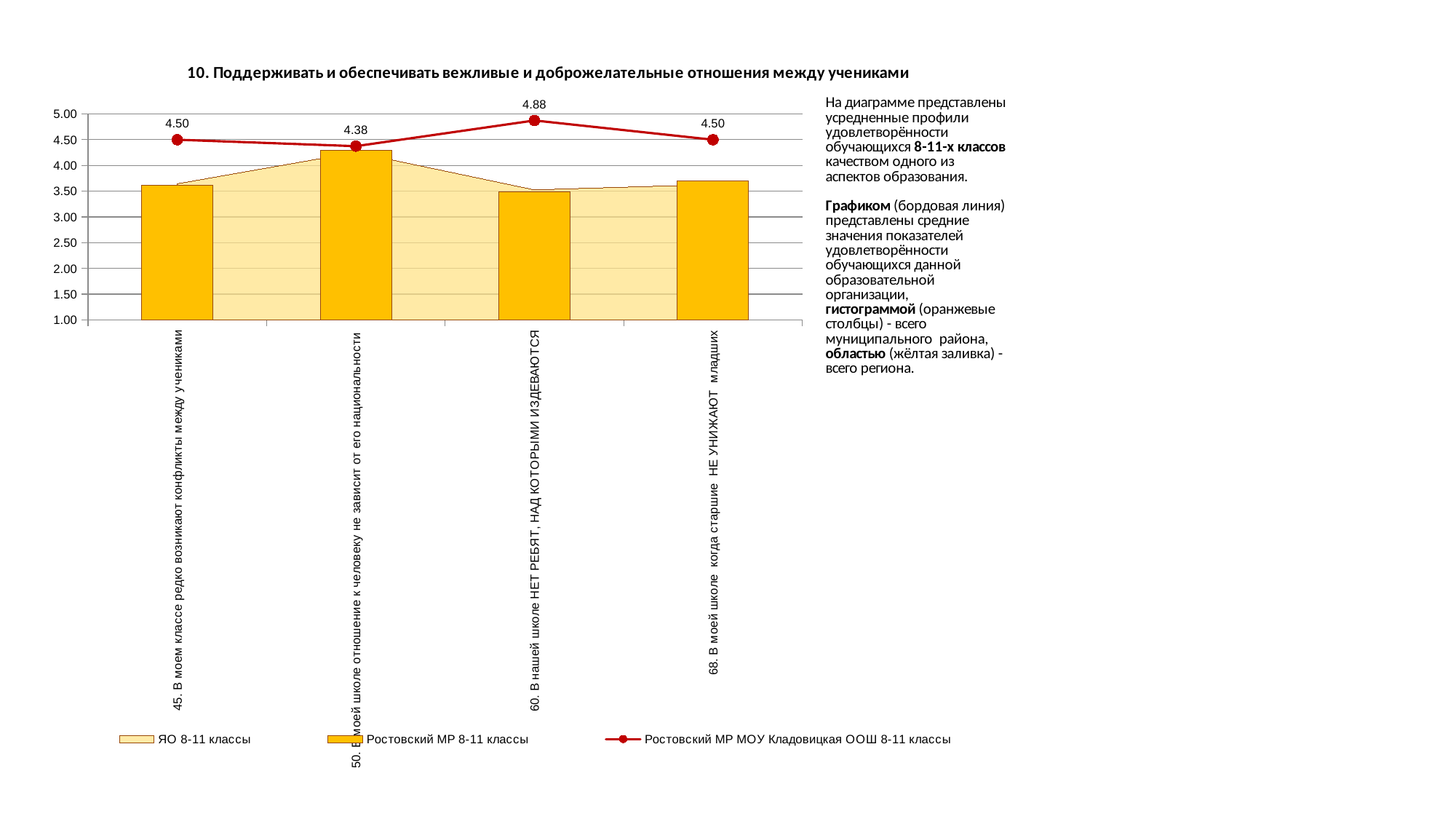
Is the orange bar for category 60 greater or less than 4.00? less How many series does the chart legend list? 3 Which category has the tallest orange bar? 50. В моей школе отношение к человеку не зависит от его национальности What value does the line series show for category "45. В моем классе редко возникают конфликты между учениками"? 4.50 For which category does the line series have its lowest value? 50. В моей школе отношение к человеку не зависит от его национальности What value does the line series show for category "50. В моей школе отношение к человеку не зависит от его национальности"? 4.38 Which category has the larger line series value: 60 or 68? 60. В нашей школе НЕТ РЕБЯТ, НАД КОТОРЫМИ ИЗДЕВАЮТСЯ How many categories are shown on the x axis of the chart? 4 What value does the line series show for category "60. В нашей школе НЕТ РЕБЯТ, НАД КОТОРЫМИ ИЗДЕВАЮТСЯ"? 4.88 What is the difference between the line series values for category 60 and category 50? 0.50 Is the orange bar for category 50 greater or less than 4.00? greater For which category does the line series reach its highest value? 60. В нашей школе НЕТ РЕБЯТ, НАД КОТОРЫМИ ИЗДЕВАЮТСЯ